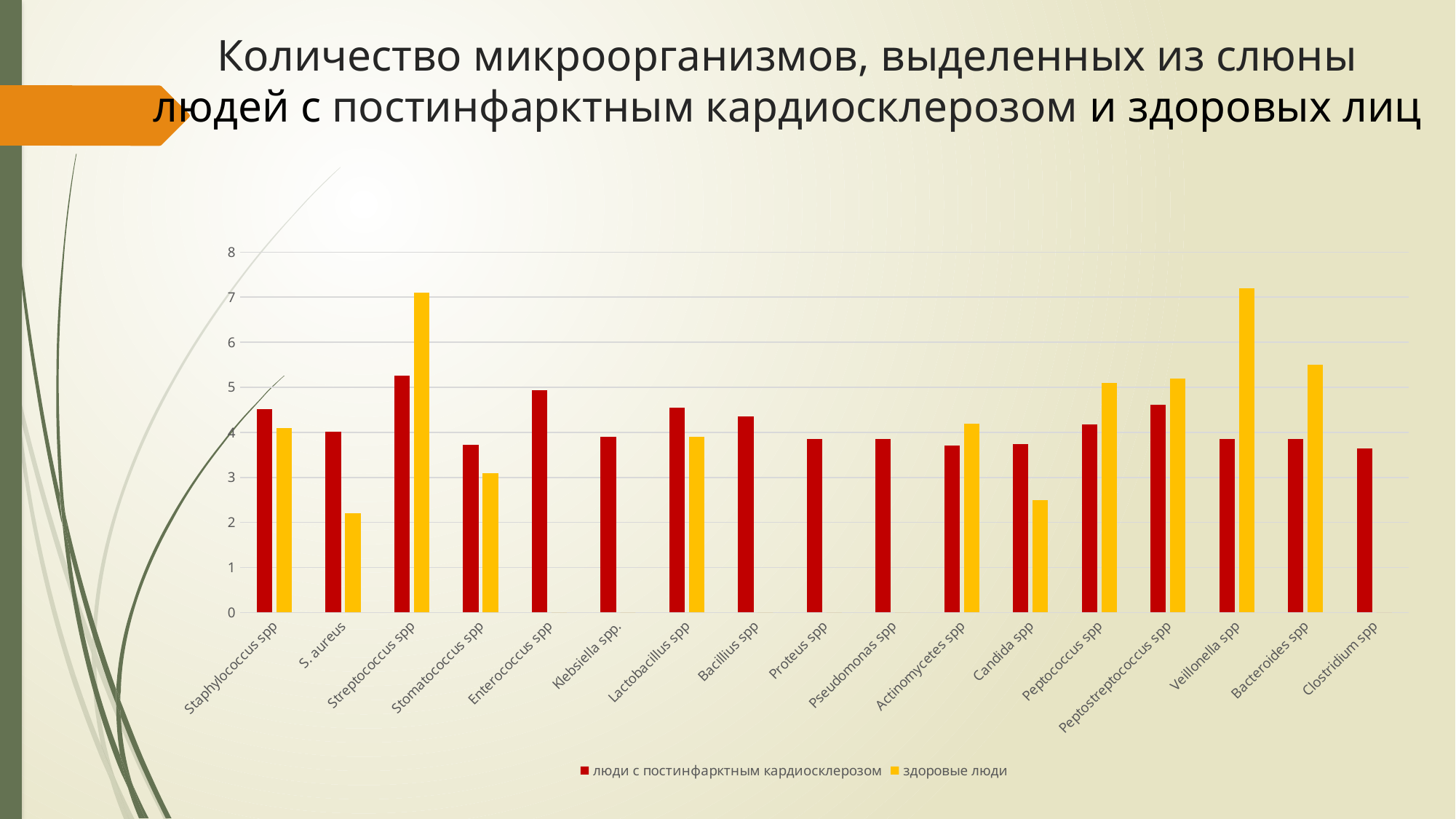
What kind of chart is shown on the slide? bar chart Is the value for 'здоровые люди' at Streptococcus spp greater or less than 6? greater What colour represents the series 'здоровые люди' in the legend? yellow Is the value for 'здоровые люди' at Bacteroides spp greater or less than 5? greater How many categories have a bar only for 'люди с постинфарктным кардиосклерозом' and no bar for 'здоровые люди'? 6 Is the value for 'люди с постинфарктным кардиосклерозом' at Enterococcus spp greater or less than 4? greater For S. aureus, which series has the larger value: 'люди с постинфарктным кардиосклерозом' or 'здоровые люди'? люди с постинфарктным кардиосклерозом How many microorganism categories are shown on the x axis? 17 For Streptococcus spp, which series has the larger value: 'люди с постинфарктным кардиосклерозом' or 'здоровые люди'? здоровые люди How many series does the legend list? 2 Which category has the highest value for the series 'люди с постинфарктным кардиосклерозом'? Streptococcus spp